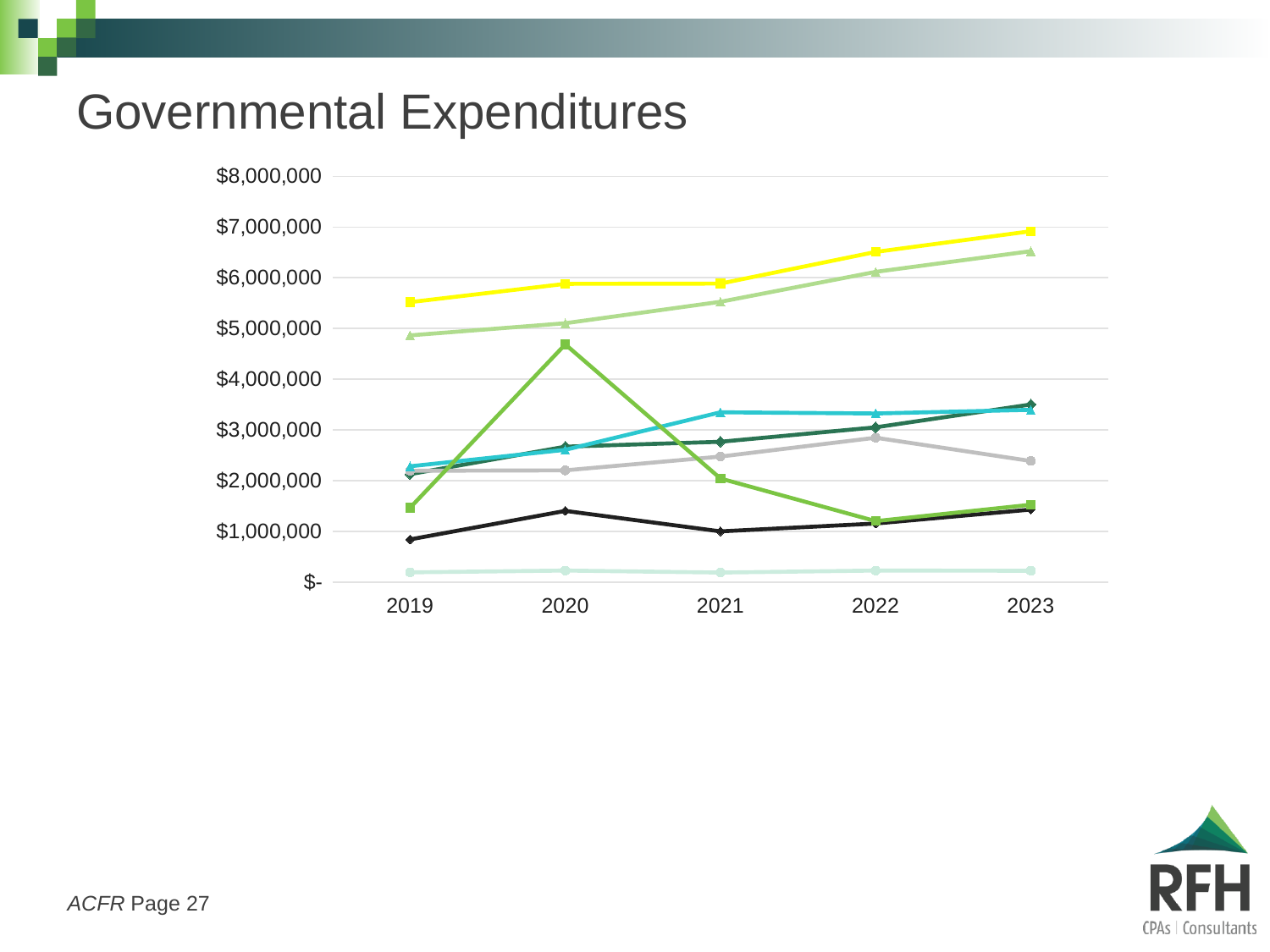
Is the value of the cyan line in 2021 greater or less than $3,000,000? greater Is the value of the bright green line in 2020 greater or less than $4,000,000? greater Which line has the highest value in 2023? the yellow line Which year has the highest value for the yellow line? 2023 Does the yellow line rise or fall from 2019 to 2023? rise How many years are shown on the x axis of the chart? 5 Is the value of the yellow line in 2023 greater or less than $6,000,000? greater What kind of chart is shown on the slide? line chart What is the title of the chart? Governmental Expenditures How many lines are plotted on the chart? 8 In which year does the bright green line reach its peak? 2020